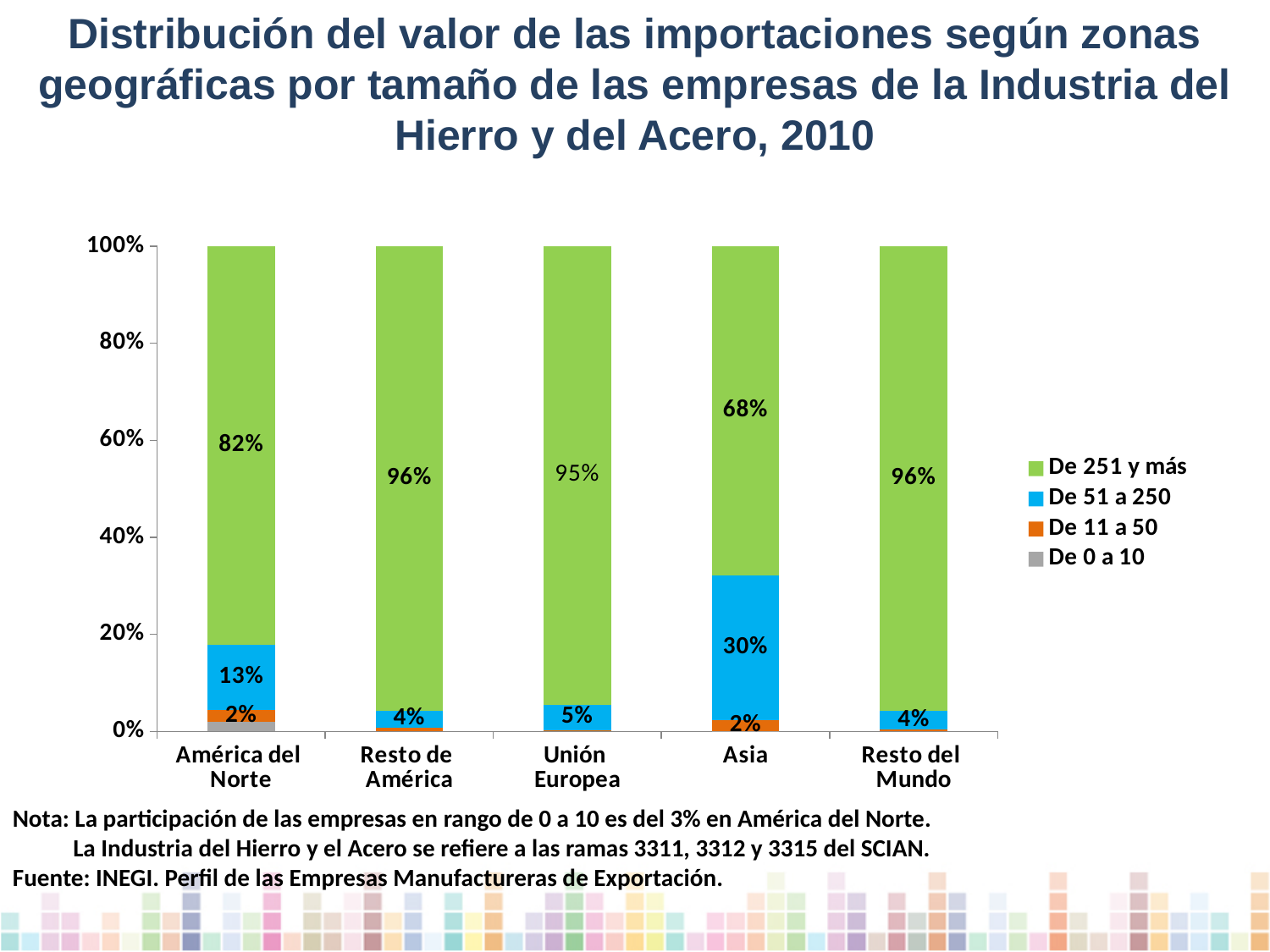
Which is larger, the 'De 251 y más' value for Resto de América or for Unión Europea? Resto de América What kind of chart is shown on the slide? Stacked bar chart What is the value for 'De 251 y más' in Unión Europea? 95% What is the value for 'De 251 y más' in Asia? 68% How many regions are shown on the x axis? 5 Which region has the lowest value for 'De 251 y más'? Asia How many series does the legend list? 4 What is the difference between the 'De 51 a 250' values for Asia and América del Norte? 17% What is the value for 'De 11 a 50' in Asia? 2% Which colour represents the 'De 51 a 250' series? Blue What is the value for 'De 51 a 250' in América del Norte? 13% Which region has the highest value for 'De 51 a 250'? Asia